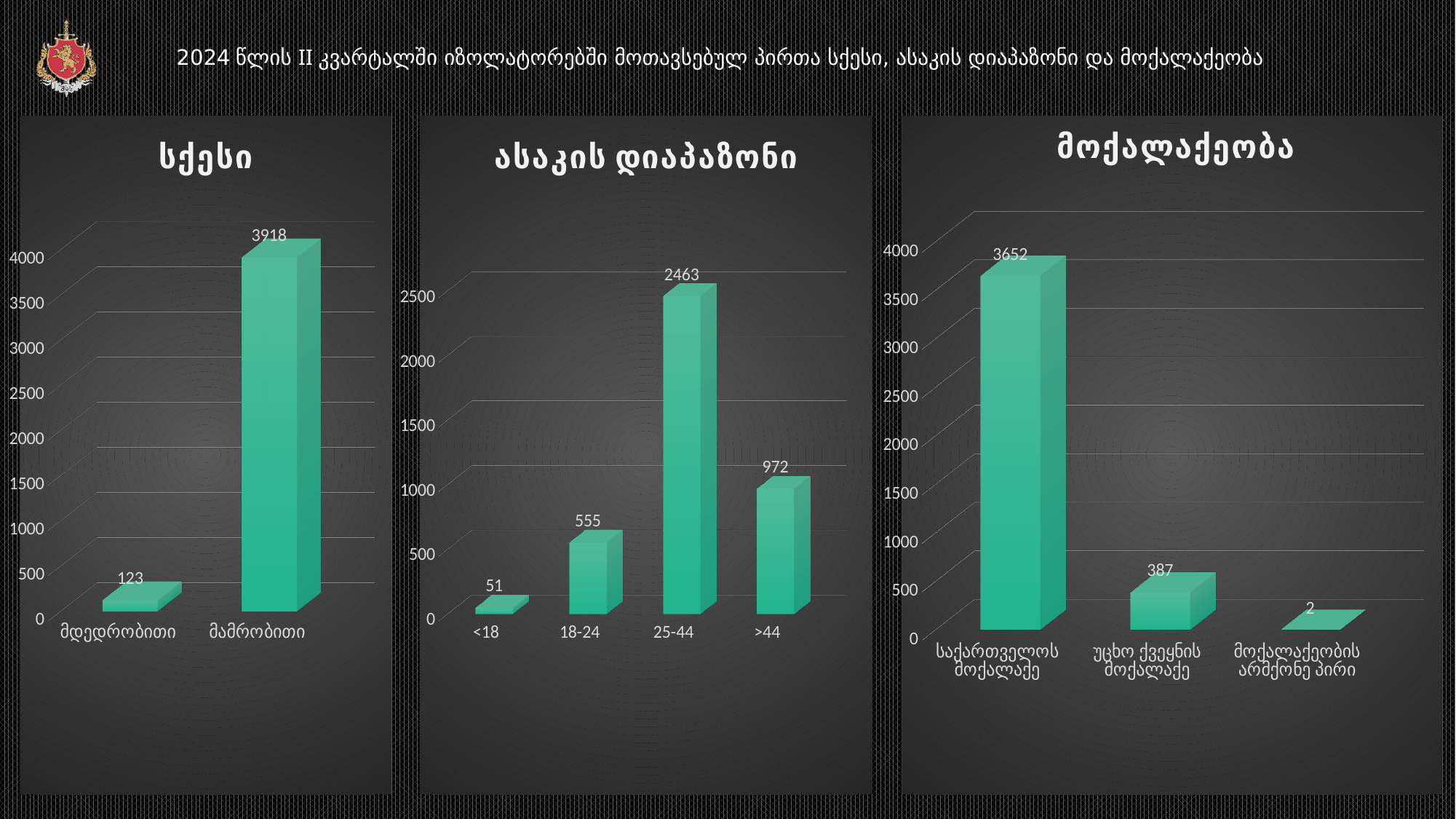
In the left chart (სქესი), what is the value for მდედრობითი? 123 In the left chart (სქესი), what is the value for მამრობითი? 3918 In the middle chart (ასაკის დიაპაზონი), what is the difference between the values for >44 and 18-24? 417 In the middle chart (ასაკის დიაპაზონი), what is the value for the 25-44 category? 2463 In the right chart (მოქალაქეობა), what is the value for მოქალაქეობის არმქონე პირი? 2 In the middle chart (ასაკის დიაპაზონი), how many categories are shown on the x axis? 4 What type of chart is the right chart (მოქალაქეობა)? bar chart In the right chart (მოქალაქეობა), which category has the highest value? საქართველოს მოქალაქე In the middle chart (ასაკის დიაპაზონი), which category has the lowest value? <18 In the middle chart (ასაკის დიაპაზონი), which is larger, the value for 18-24 or the value for >44? >44 In the left chart (სქესი), what is the difference between the values for მამრობითი and მდედრობითი? 3795 In the right chart (მოქალაქეობა), what is the value for უცხო ქვეყნის მოქალაქე? 387